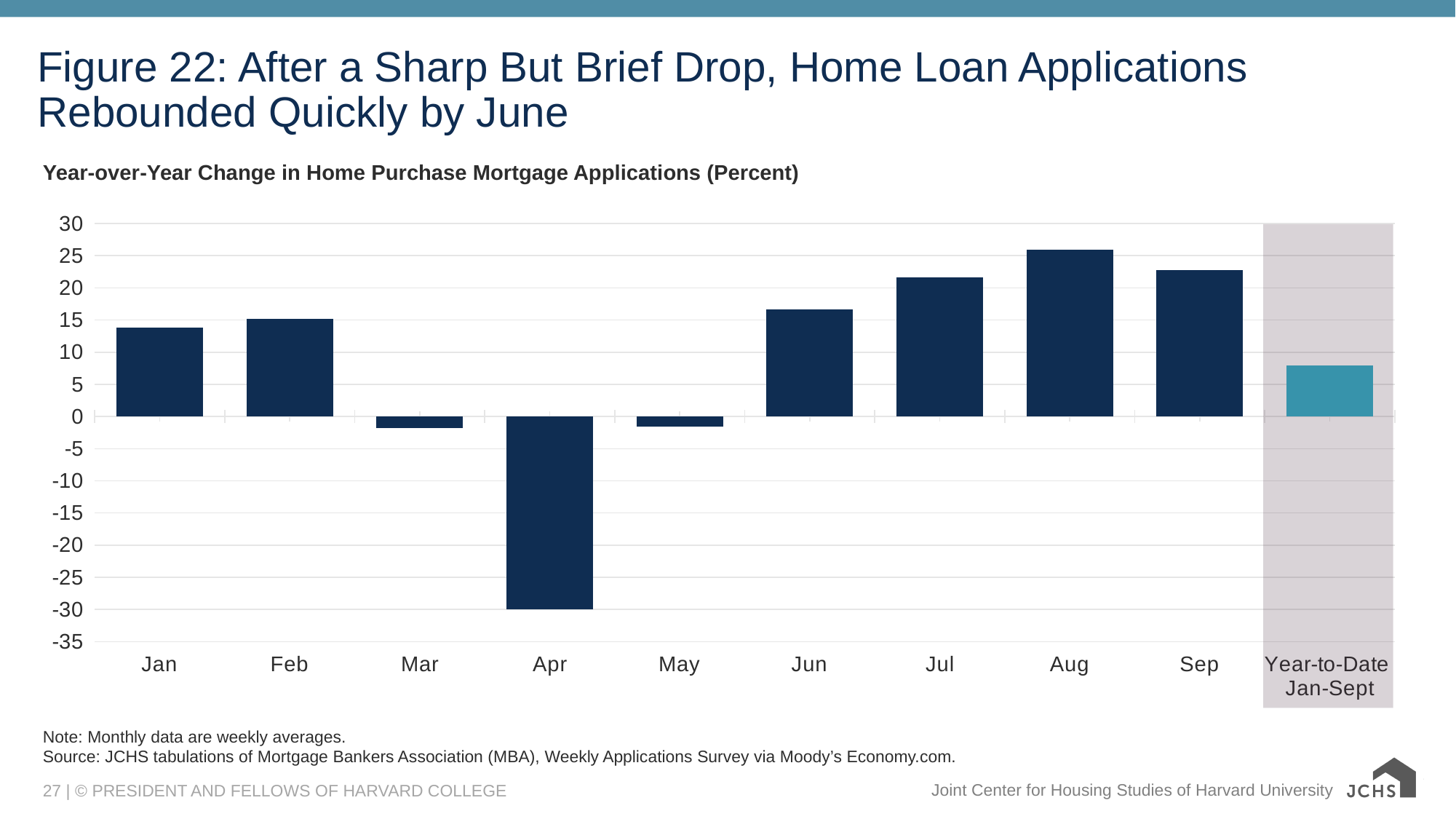
Do the values rise or fall from Jun to Aug? Rise Is the value for Apr greater or less than -25? less Is the value for Jun greater or less than 15? greater Which is larger, the value for Aug or the value for Jun? Aug Is the value for Jul greater or less than 20? greater What kind of chart is shown on the slide? Bar chart Which bar is drawn in a different (lighter blue) colour from the others? Year-to-Date Jan-Sept How many categories are shown along the x axis? 10 What is the subtitle describing the measure plotted in the chart? Year-over-Year Change in Home Purchase Mortgage Applications (Percent) Which month has the highest year-over-year change in home purchase mortgage applications? Aug Which month has the lowest year-over-year change in home purchase mortgage applications? Apr